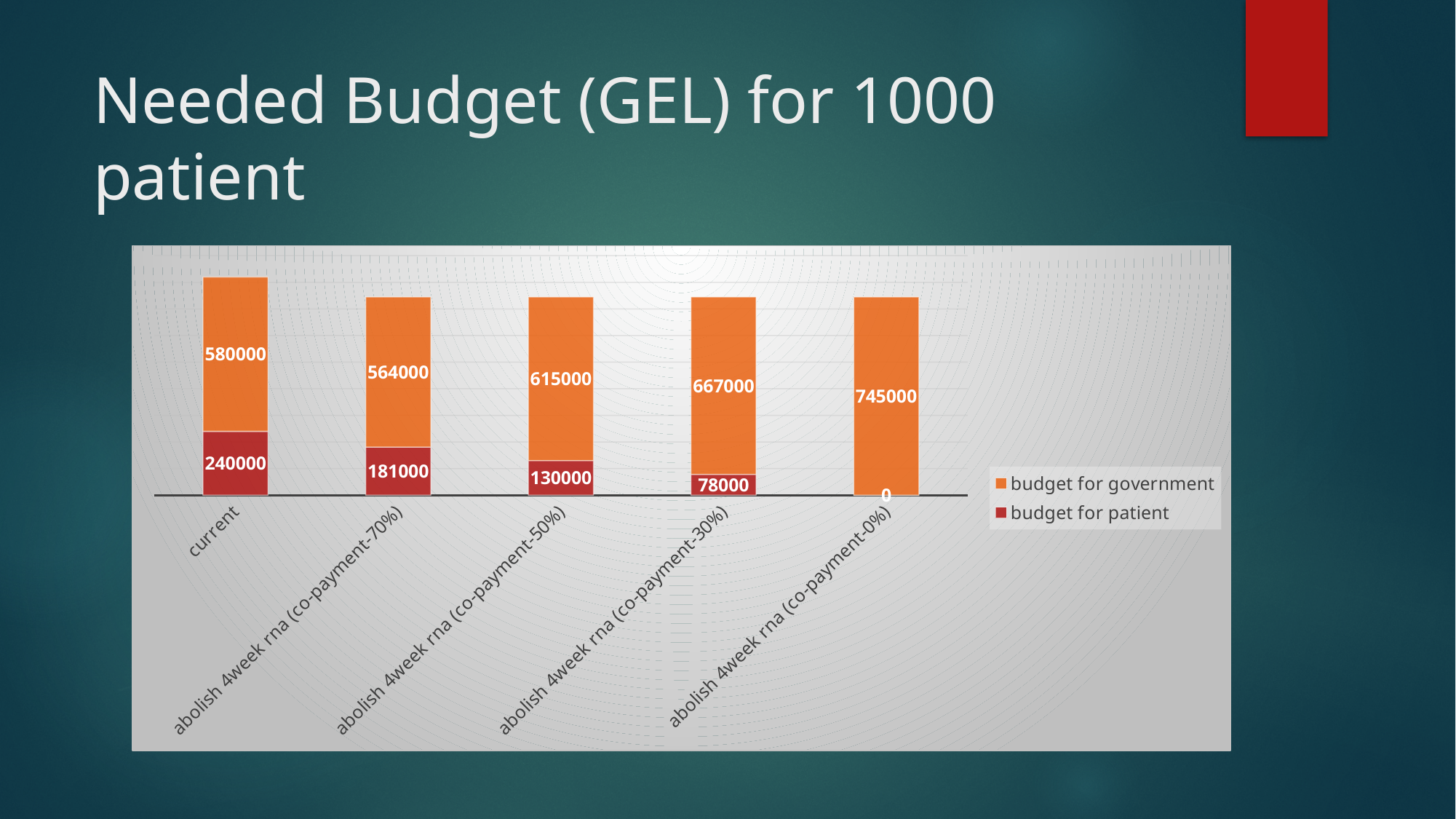
What is the budget for government for the 'current' category? 580000 What is the budget for government under 'abolish 4week rna (co-payment-50%)'? 615000 What is the budget for patient under 'abolish 4week rna (co-payment-30%)'? 78000 How many categories are shown on the x axis? 5 What kind of chart is shown on the slide? stacked bar chart How many series does the legend list? 2 Which category has the highest budget for government? abolish 4week rna (co-payment-0%) What is the total of the stacked bar for 'abolish 4week rna (co-payment-50%)'? 745000 Which is larger: the budget for government for 'current' or for 'abolish 4week rna (co-payment-70%)'? current Which category has the lowest budget for patient? abolish 4week rna (co-payment-0%) What is the difference between the budget for patient for 'current' and for 'abolish 4week rna (co-payment-70%)'? 59000 What is the total of the stacked bar for 'current'? 820000